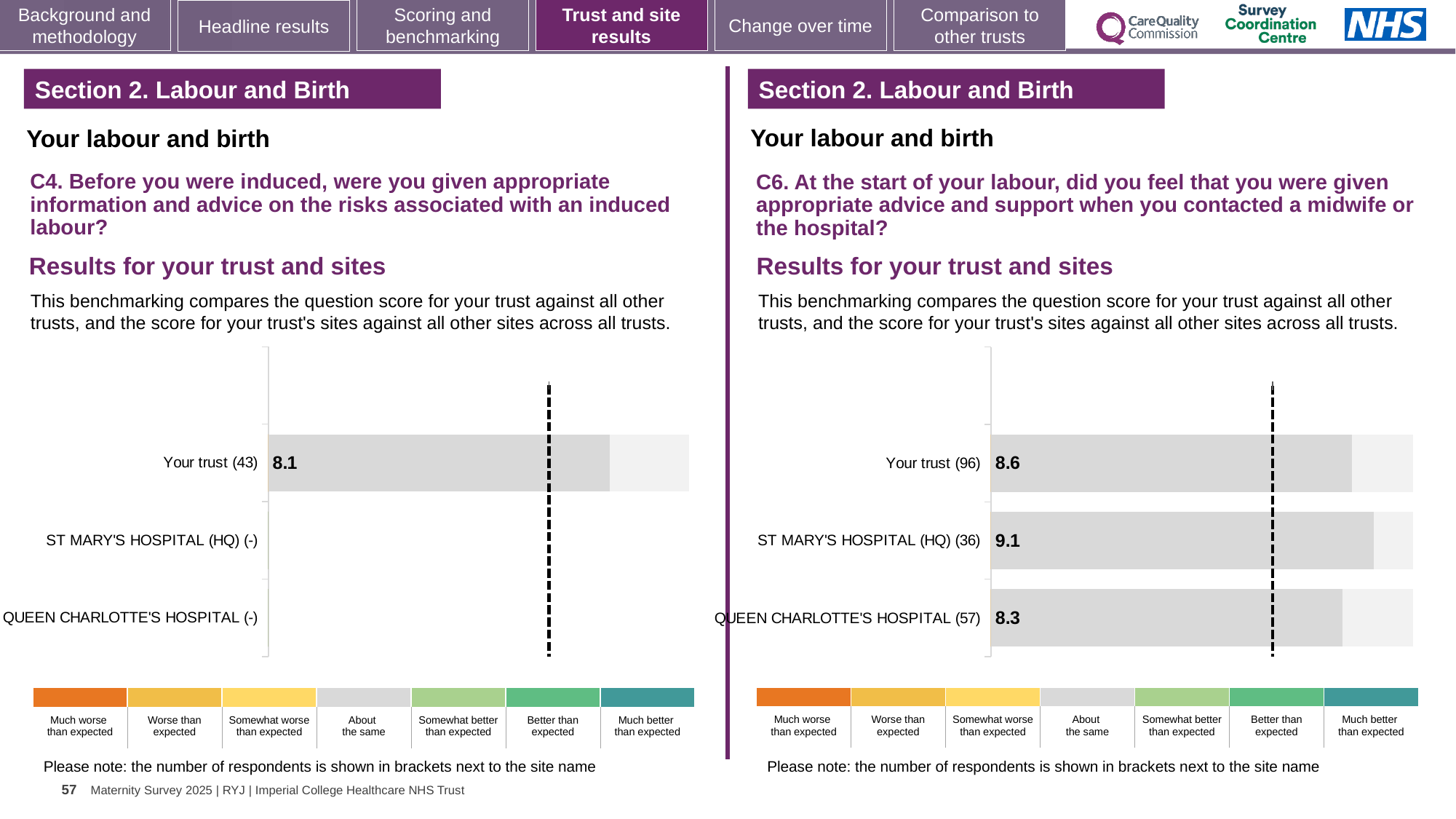
What kind of chart is the C6 chart on the right? Bar chart In the C6 chart on the right, what is the score for ST MARY'S HOSPITAL (HQ)? 9.1 In the C6 chart on the right, which category has the highest score? ST MARY'S HOSPITAL (HQ) In the C6 chart on the right, what is the difference between the scores for ST MARY'S HOSPITAL (HQ) and QUEEN CHARLOTTE'S HOSPITAL? 0.8 In the C6 chart on the right, how many respondents are shown in brackets for QUEEN CHARLOTTE'S HOSPITAL? 57 In the C6 chart on the right, which category has the lowest score? QUEEN CHARLOTTE'S HOSPITAL In the C6 chart on the right, what is the score for QUEEN CHARLOTTE'S HOSPITAL? 8.3 In the C4 chart on the left, what is the score for Your trust? 8.1 In the C4 chart on the left, how many respondents are shown in brackets for Your trust? 43 In the C6 chart on the right, what is the score for Your trust? 8.6 In the C6 chart on the right, which has a higher score, Your trust or ST MARY'S HOSPITAL (HQ)? ST MARY'S HOSPITAL (HQ) How many categories are listed on the y axis of the C4 chart on the left? 3